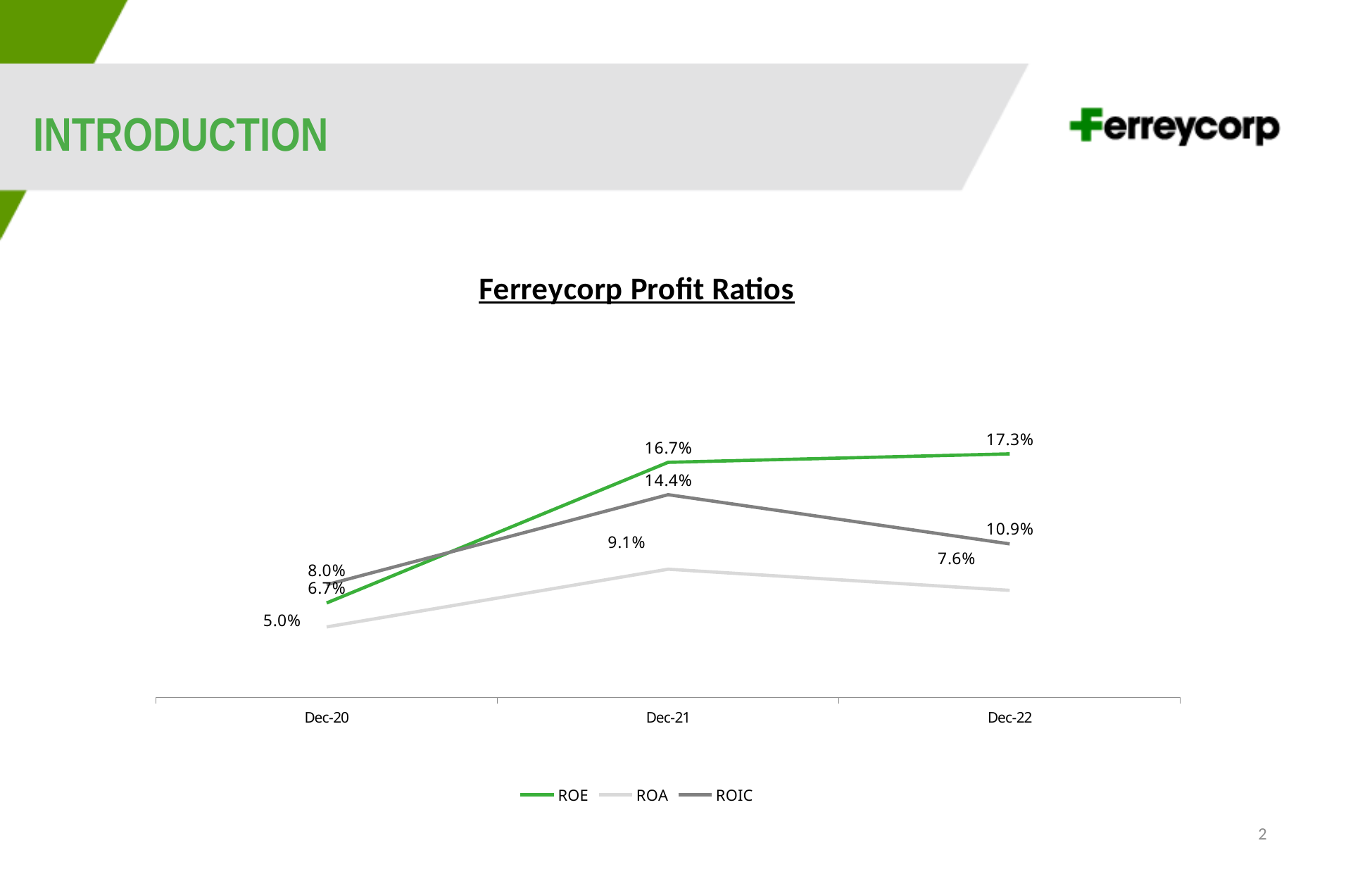
How many series does the legend list? 3 How many dates are shown on the x axis? 3 Does ROIC rise or fall from Dec-21 to Dec-22? Fall What is the ROE value at Dec-21? 16.7% What is the ROIC value at Dec-20? 8.0% What is the ROA value at Dec-20? 5.0% What is the ROIC value at Dec-22? 10.9% Which is larger at Dec-20, ROE or ROIC? ROIC What kind of chart is shown on the slide? Line chart What is the difference between ROE and ROIC at Dec-22? 6.4% At which date is ROE highest? Dec-22 At which date is ROA lowest? Dec-20